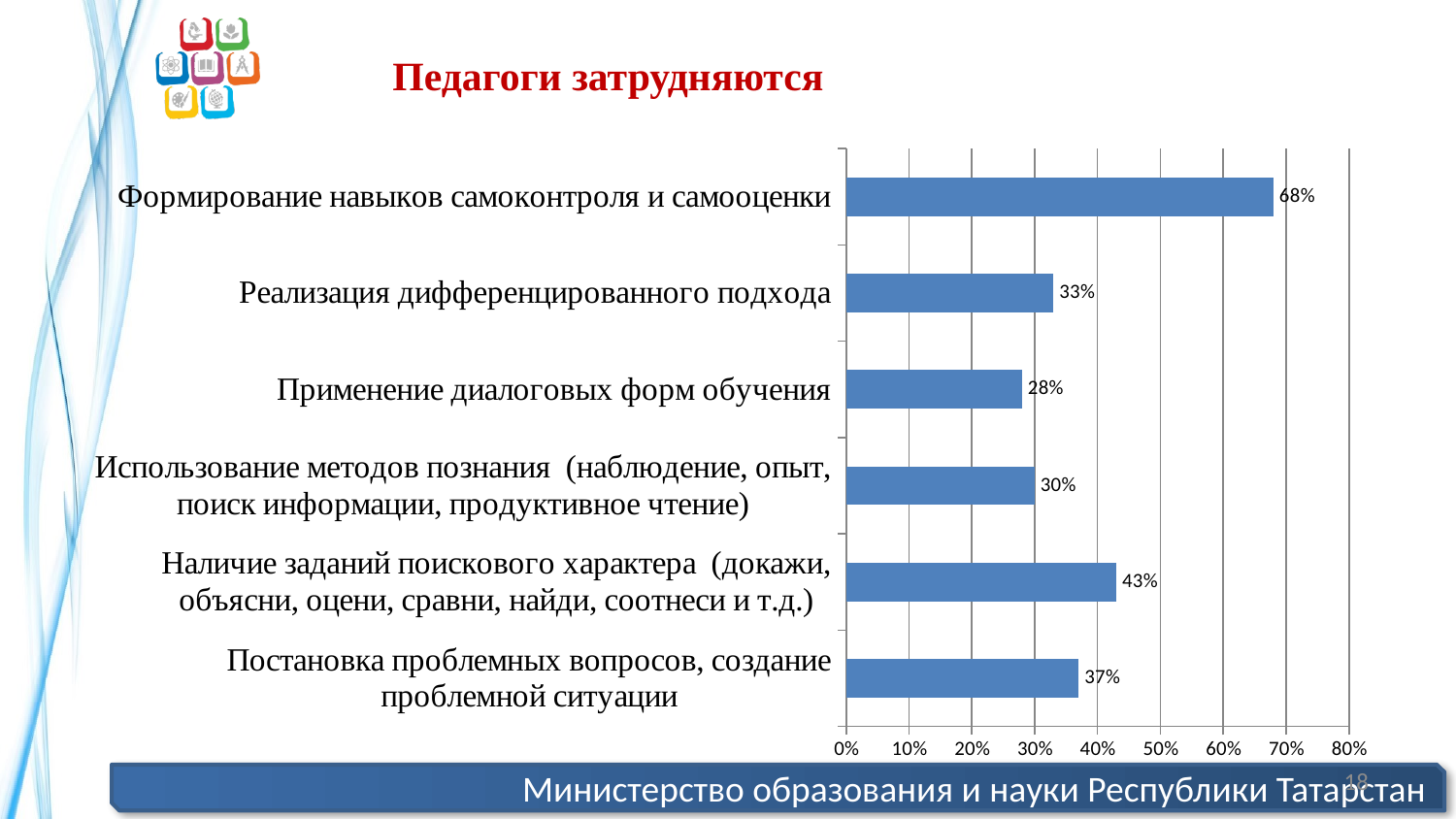
What is the value for "Формирование навыков самоконтроля и самооценки"? 68% Is the value for "Реализация дифференцированного подхода" greater or less than 40%? less Which category has the highest value? Формирование навыков самоконтроля и самооценки How many categories are shown in the chart? 6 What is the title of the slide above the chart? Педагоги затрудняются What is the value for "Применение диалоговых форм обучения"? 28% What kind of chart is shown on the slide? bar chart Which category has the lowest value? Применение диалоговых форм обучения What is the difference between the values for "Формирование навыков самоконтроля и самооценки" and "Наличие заданий поискового характера"? 25% What is the value for "Реализация дифференцированного подхода"? 33% Which is larger: the value for "Постановка проблемных вопросов, создание проблемной ситуации" or for "Использование методов познания"? Постановка проблемных вопросов, создание проблемной ситуации What is the value for "Наличие заданий поискового характера (докажи, объясни, оцени, сравни, найди, соотнеси и т.д.)"? 43%